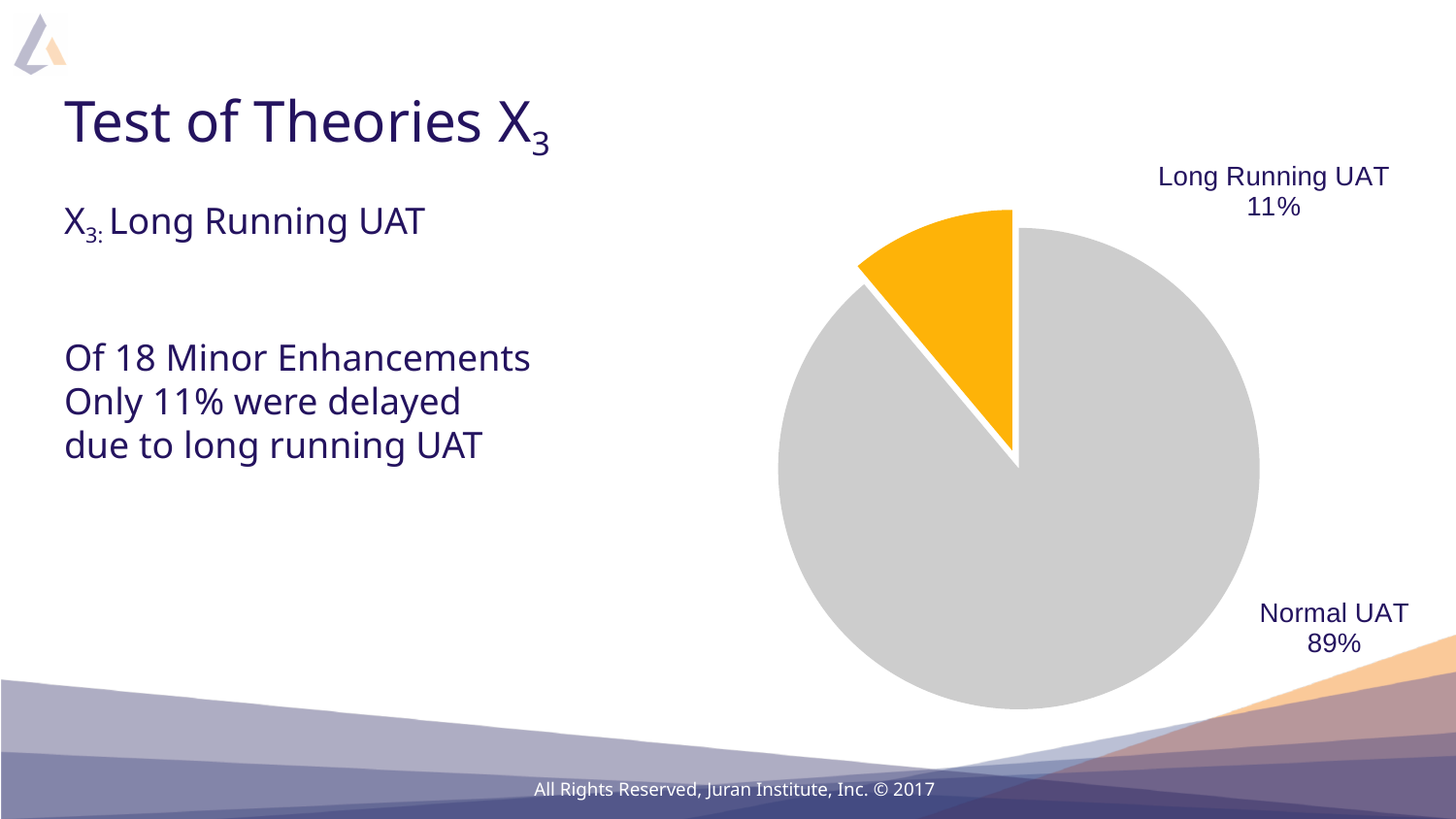
What colour is the Long Running UAT slice? orange What is the difference in percentage points between Normal UAT and Long Running UAT? 78 Which is larger, the Long Running UAT slice or the Normal UAT slice? Normal UAT Which slice of the pie is the smallest? Long Running UAT What share of the pie does Normal UAT represent? 89% What colour is the Normal UAT slice? grey Which slice of the pie is the largest? Normal UAT How many slices does the pie chart have? 2 What share of the pie does Long Running UAT represent? 11% What kind of chart is shown on the slide? pie chart